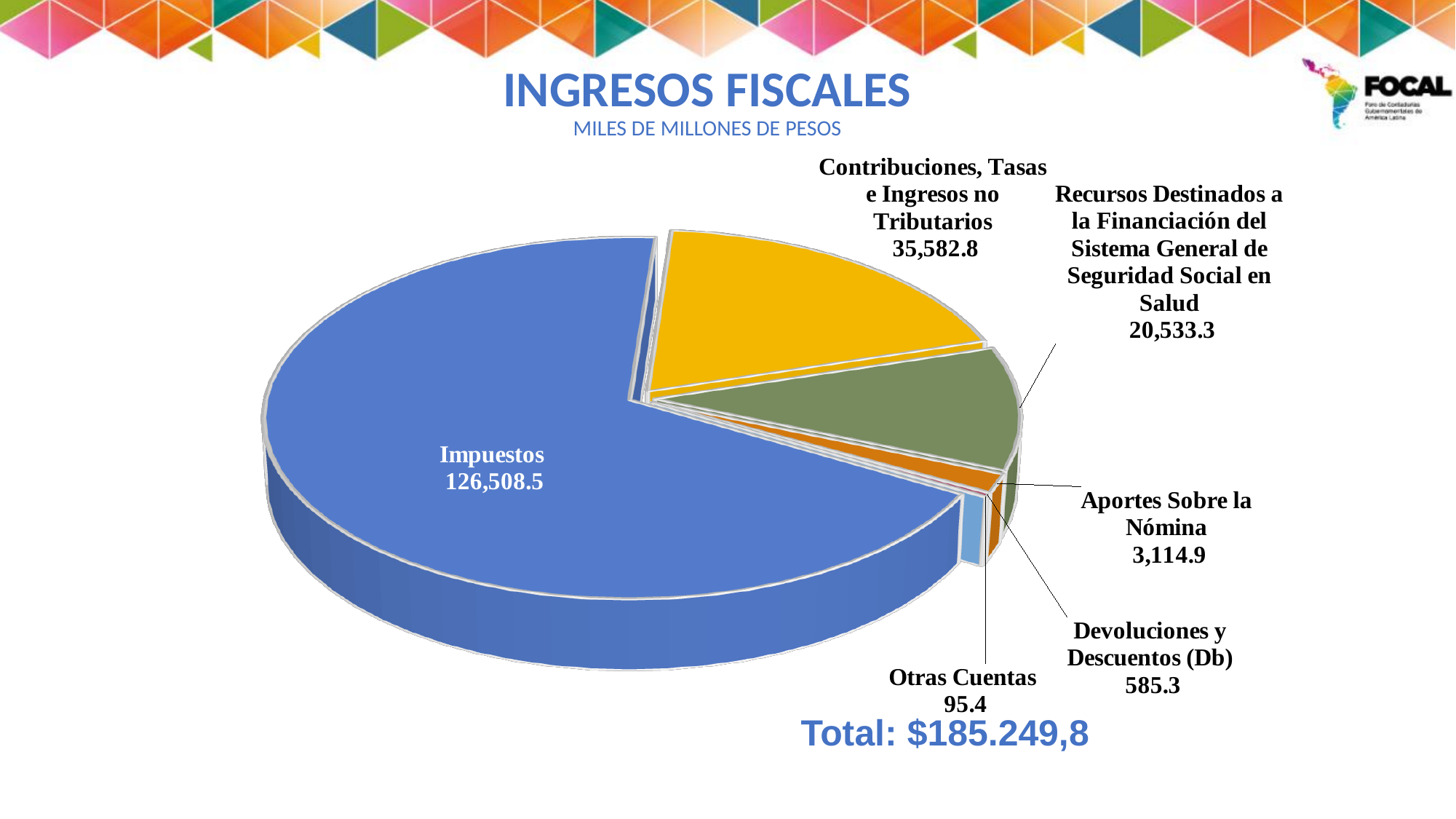
Which category has the largest slice of the pie? Impuestos Which is larger, Contribuciones, Tasas e Ingresos no Tributarios or Recursos Destinados a la Financiación del Sistema General de Seguridad Social en Salud? Contribuciones, Tasas e Ingresos no Tributarios What is the value for Otras Cuentas? 95.4 What is the difference between Impuestos and Contribuciones, Tasas e Ingresos no Tributarios? 90,925.7 What is the value for Aportes Sobre la Nómina? 3,114.9 Which category has the smallest value? Otras Cuentas What is the difference between Aportes Sobre la Nómina and Devoluciones y Descuentos (Db)? 2,529.6 What is the value for Impuestos? 126,508.5 How many categories are shown in the pie chart? 6 What is the value for Recursos Destinados a la Financiación del Sistema General de Seguridad Social en Salud? 20,533.3 What is the value for Contribuciones, Tasas e Ingresos no Tributarios? 35,582.8 What kind of chart is shown on the slide? Pie chart